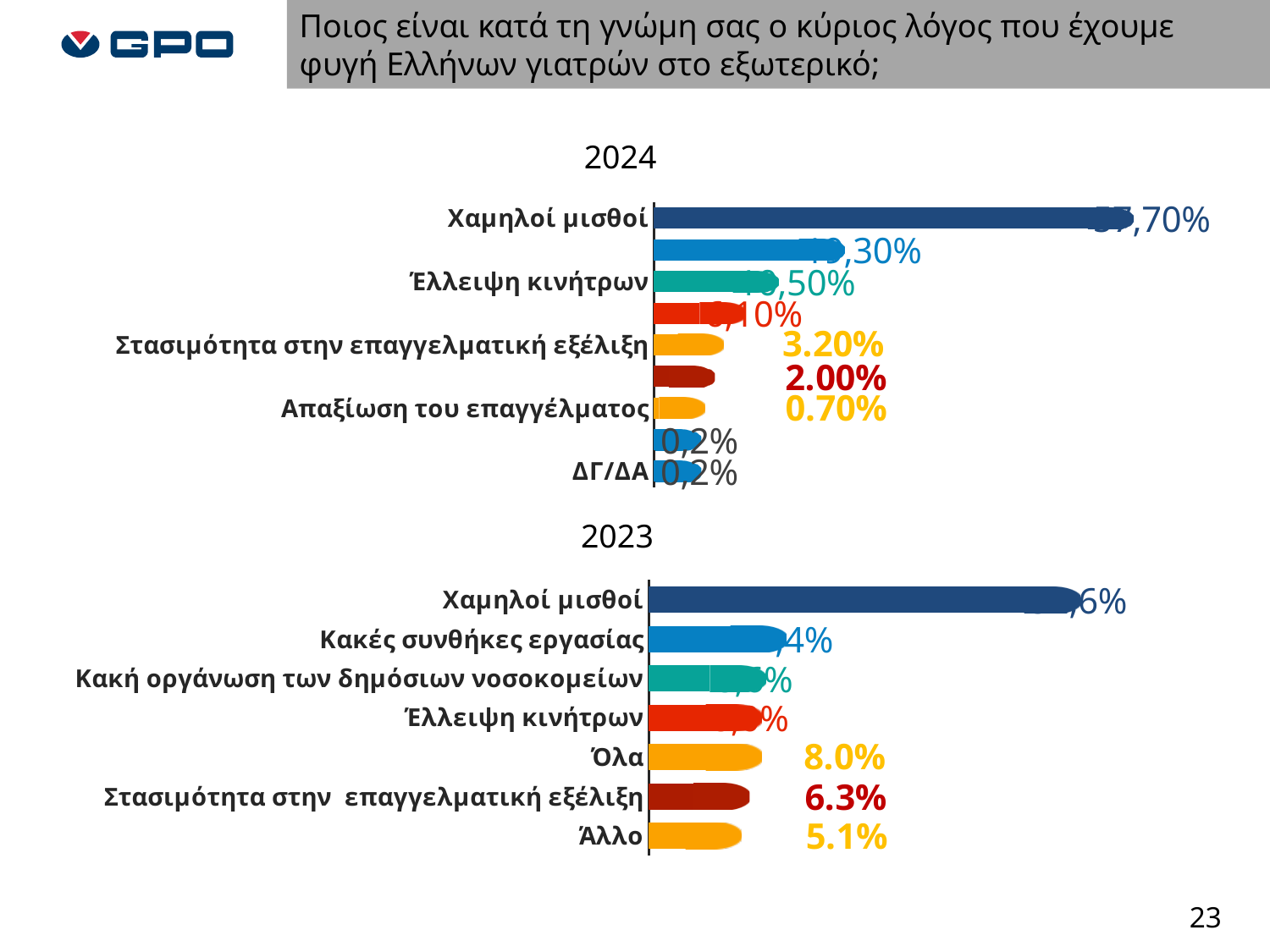
In the 2023 chart, which category has the lowest value? Άλλο In the 2023 chart, what is the value for Στασιμότητα στην επαγγελματική εξέλιξη? 6.3% In the 2024 chart, which category has the highest value? Χαμηλοί μισθοί In the 2023 chart, how many categories are shown? 7 In the 2023 chart, what is the value for Όλα? 8.0% In the 2024 chart, what is the value for Στασιμότητα στην επαγγελματική εξέλιξη? 3.20% In the 2023 chart, what is the difference between the values for Όλα and Άλλο? 2.9% In the 2023 chart, which category has the highest value? Χαμηλοί μισθοί In the 2023 chart, what is the value for Άλλο? 5.1% In the 2023 chart, which is larger: Κακές συνθήκες εργασίας or Έλλειψη κινήτρων? Κακές συνθήκες εργασίας In the 2024 chart, what is the value for ΔΓ/ΔΑ? 0,2% What kind of chart is the 2024 chart? bar chart